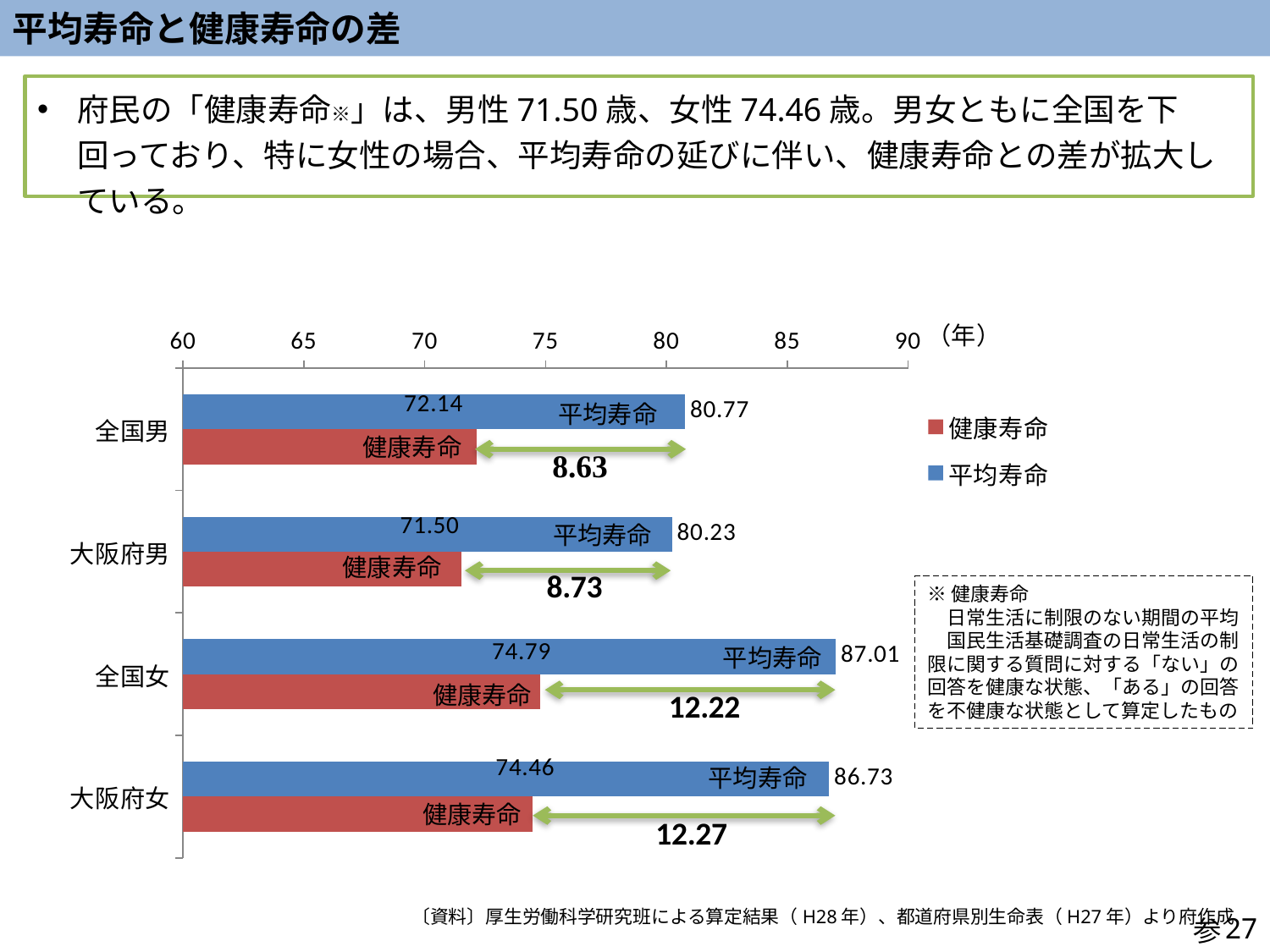
What is the 平均寿命 value for 全国女? 87.01 What is the 平均寿命 value for 大阪府女? 86.73 Which category has the lowest 健康寿命? 大阪府男 How many series does the legend list? 2 How many categories are shown on the chart? 4 Which category has the highest 平均寿命? 全国女 What is the difference between 平均寿命 and 健康寿命 for 全国男? 8.63 What is the 健康寿命 value for 全国男? 72.14 What is the 健康寿命 value for 大阪府男? 71.50 Which is larger, the 健康寿命 for 全国女 or the 健康寿命 for 大阪府男? 全国女 What is the difference between 平均寿命 and 健康寿命 for 大阪府女? 12.27 What kind of chart is shown on the slide? Bar chart